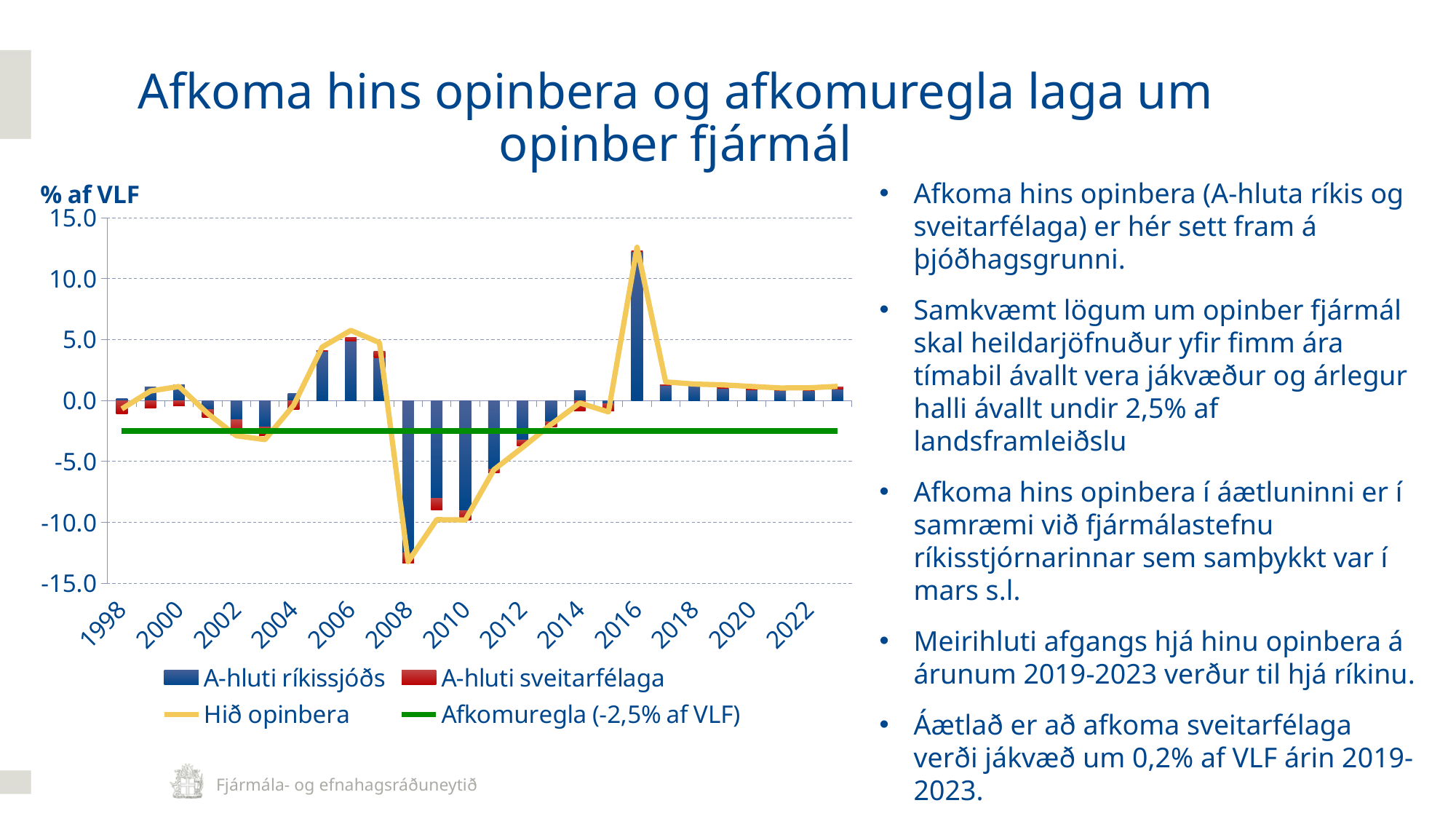
Is the value of the Hið opinbera line in 2016 greater or less than 10.0? greater Which year has the larger Hið opinbera value, 2006 or 2016? 2016 What is the label on the vertical axis of the chart? % af VLF What kind of chart is shown on the slide? A combined bar and line chart Which series is shown in red in the chart? A-hluti sveitarfélaga Does the Hið opinbera line rise or fall between 2006 and 2008? Fall In which year does the Hið opinbera line reach its highest value? 2016 How many series does the chart legend list? 4 Is the value of the Hið opinbera line in 2012 greater or less than 0.0? less In which year does the Hið opinbera line reach its lowest value? 2008 At what level is the Afkomuregla line drawn, according to the legend? -2,5% af VLF Is the value of the Hið opinbera line in 2008 greater or less than -10.0? less